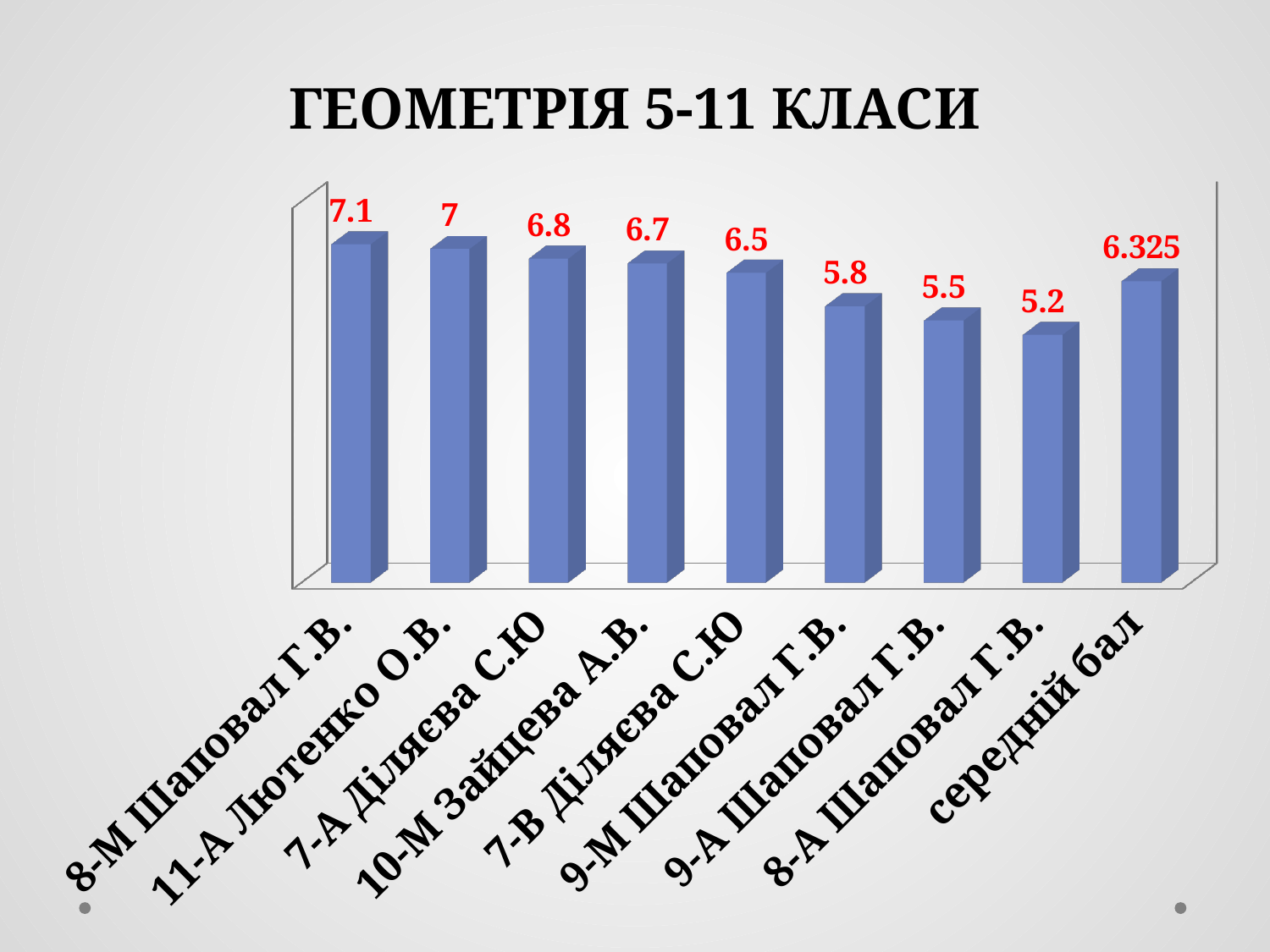
What kind of chart is shown on the slide? Bar chart Which category has the lowest value? 8-А Шаповал Г.В. Which is larger, the value for 7-В Діляєва С.Ю or the value for 9-М Шаповал Г.В.? 7-В Діляєва С.Ю What is the value for 11-А Лютенко О.В.? 7 How many bars are shown in the chart? 9 What is the difference between the values for 8-М Шаповал Г.В. and 8-А Шаповал Г.В.? 1.9 Which category has the highest value? 8-М Шаповал Г.В. What is the value for 8-А Шаповал Г.В.? 5.2 What is the value shown for середній бал? 6.325 What is the value for 10-М Зайцева А.В.? 6.7 What is the value for 8-М Шаповал Г.В.? 7.1 What is the title of the chart? ГЕОМЕТРІЯ 5-11 КЛАСИ